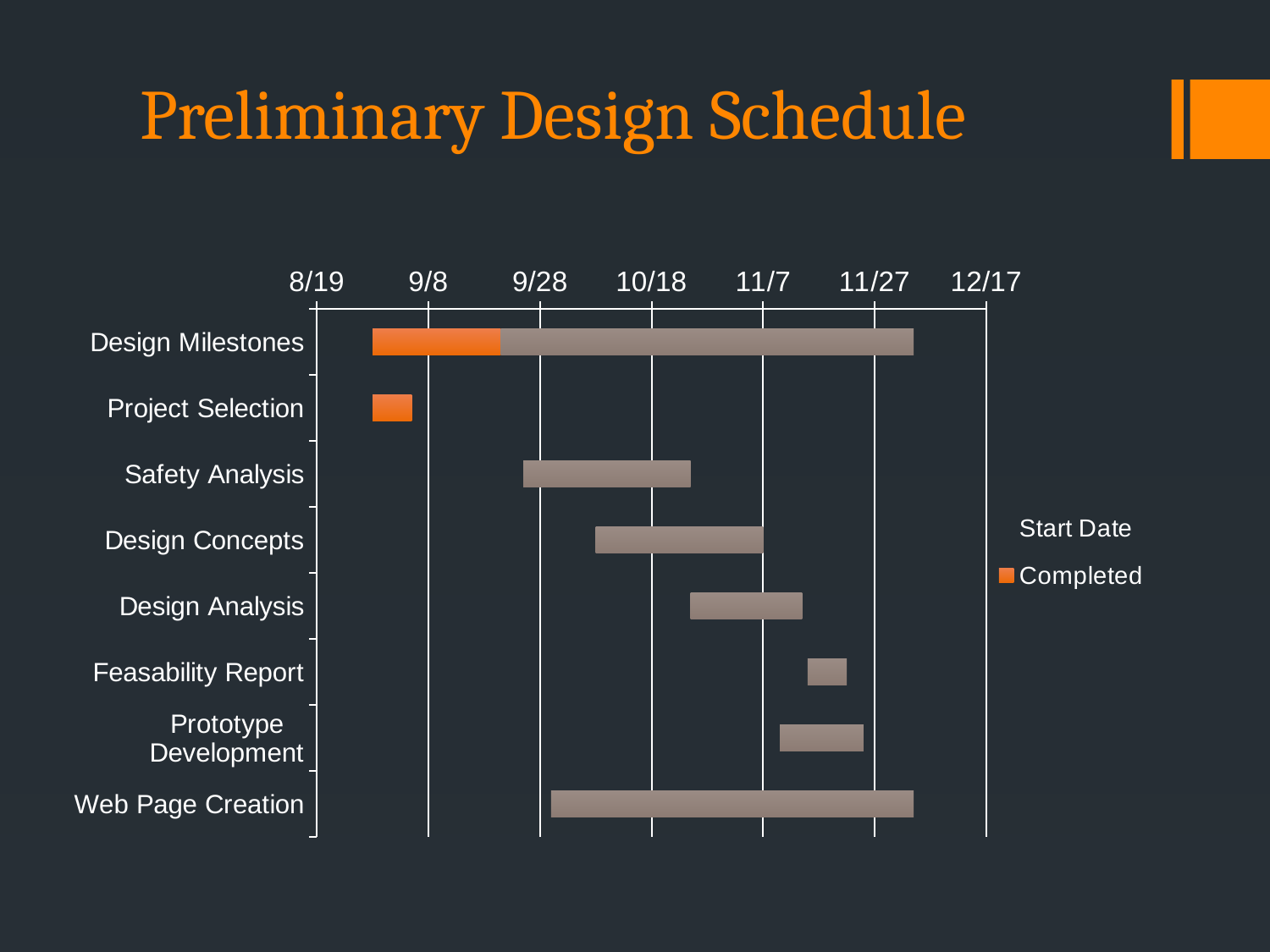
How many entries does the chart's legend list? 2 What kind of chart is shown on the slide? Bar chart Which task has the longest bar in the chart? Design Milestones How many tasks are listed on the vertical axis of the chart? 8 Does the Feasability Report bar start before or after 11/7? after Does the Prototype Development bar end before or after 11/27? before Does the Web Page Creation bar end before or after 12/17? before Which task is shown entirely in the Completed colour? Project Selection What is the title of the slide containing the chart? Preliminary Design Schedule Which task starts earlier, Design Concepts or Design Analysis? Design Concepts